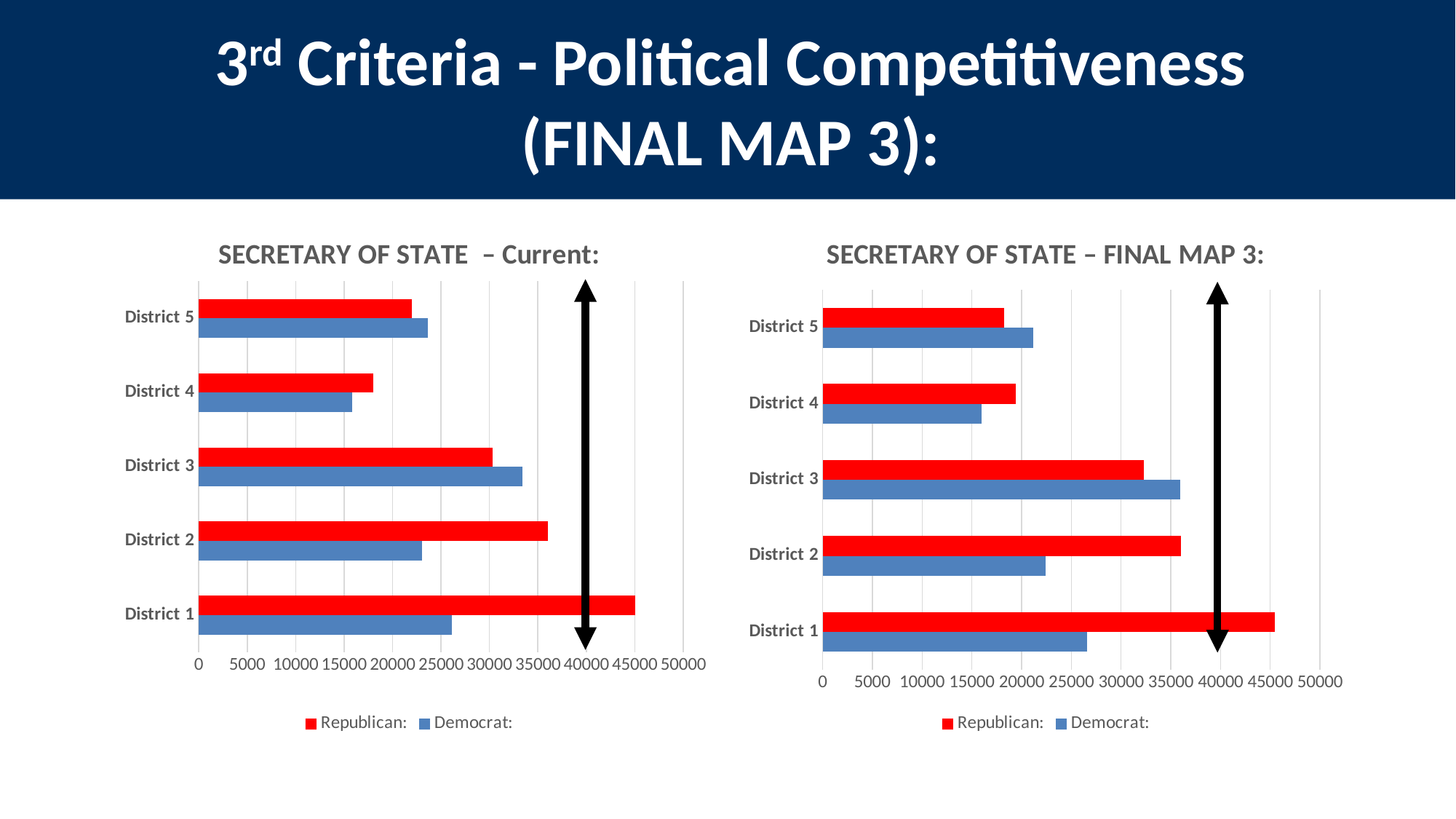
On the "SECRETARY OF STATE – FINAL MAP 3:" chart, which district has the lowest Democrat value? District 4 How many districts are shown on the "SECRETARY OF STATE – Current:" chart? 5 What kind of chart is the "SECRETARY OF STATE – Current:" chart? bar chart On the "SECRETARY OF STATE – FINAL MAP 3:" chart, which district has the highest Republican value? District 1 On the "SECRETARY OF STATE – FINAL MAP 3:" chart, which is larger for District 3, the Republican or the Democrat value? Democrat On the "SECRETARY OF STATE – Current:" chart, which district has the highest Republican value? District 1 On the "SECRETARY OF STATE – FINAL MAP 3:" chart, is the Democrat value for District 3 greater or less than 30000? greater How many series does the legend of the "SECRETARY OF STATE – FINAL MAP 3:" chart list? 2 On the "SECRETARY OF STATE – Current:" chart, is the Republican value for District 1 greater or less than 40000? greater On the "SECRETARY OF STATE – Current:" chart, which is larger for District 2, the Republican or the Democrat value? Republican On the "SECRETARY OF STATE – Current:" chart, is the Democrat value for District 4 greater or less than 20000? less What are the two legend entries on the "SECRETARY OF STATE – FINAL MAP 3:" chart? Republican and Democrat